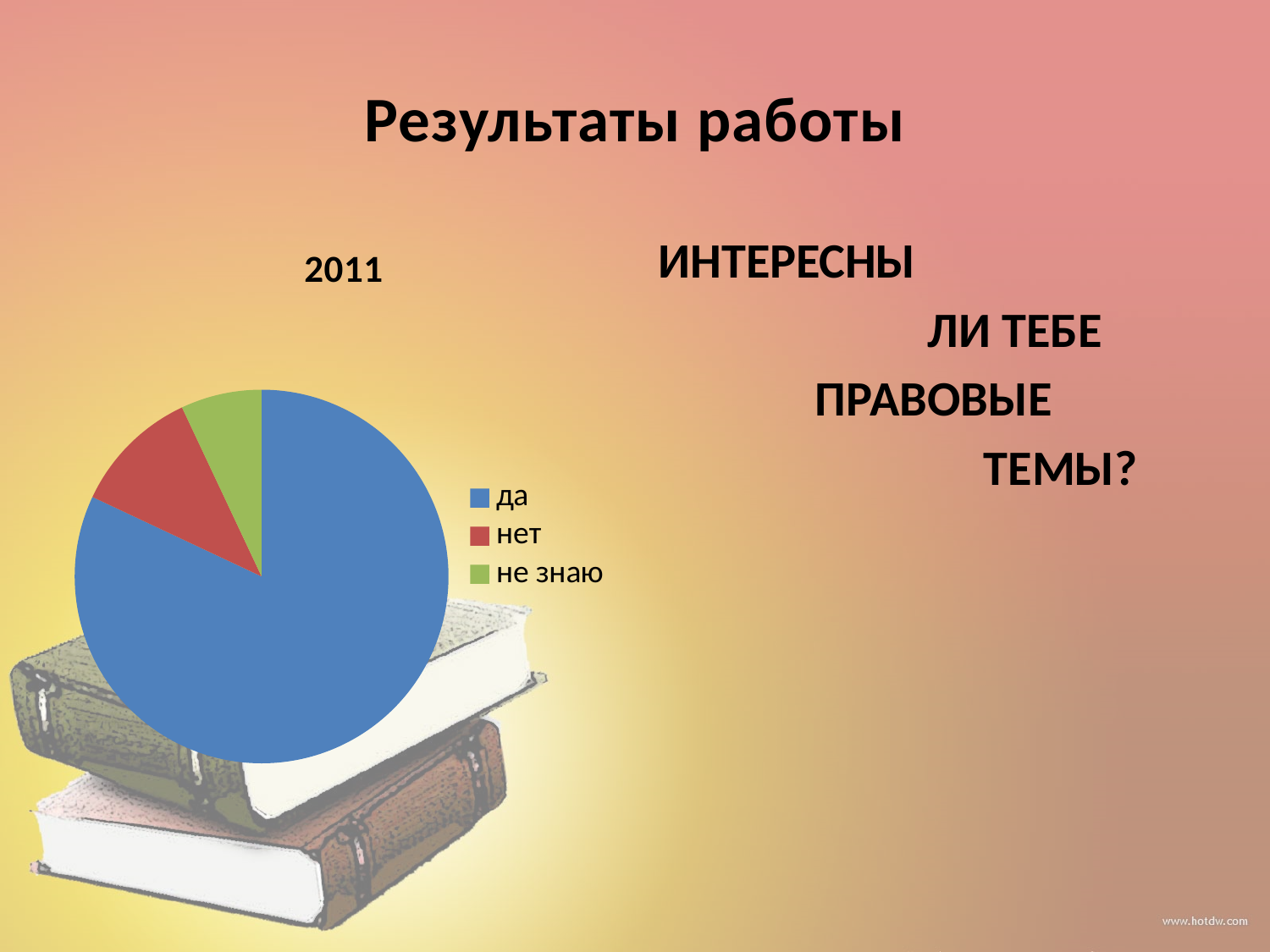
Which slice is larger in the pie chart, "нет" or "не знаю"? нет What is the title of the pie chart? 2011 What kind of chart is shown on the slide? pie chart How many slices does the pie chart have? 3 Which category is shown in green in the pie chart? не знаю What colour represents the "да" category in the pie chart? blue Which category has the largest slice in the pie chart? да Which category has the smallest slice in the pie chart? не знаю How many categories does the pie chart's legend list? 3 Which slice is larger in the pie chart, "да" or "нет"? да